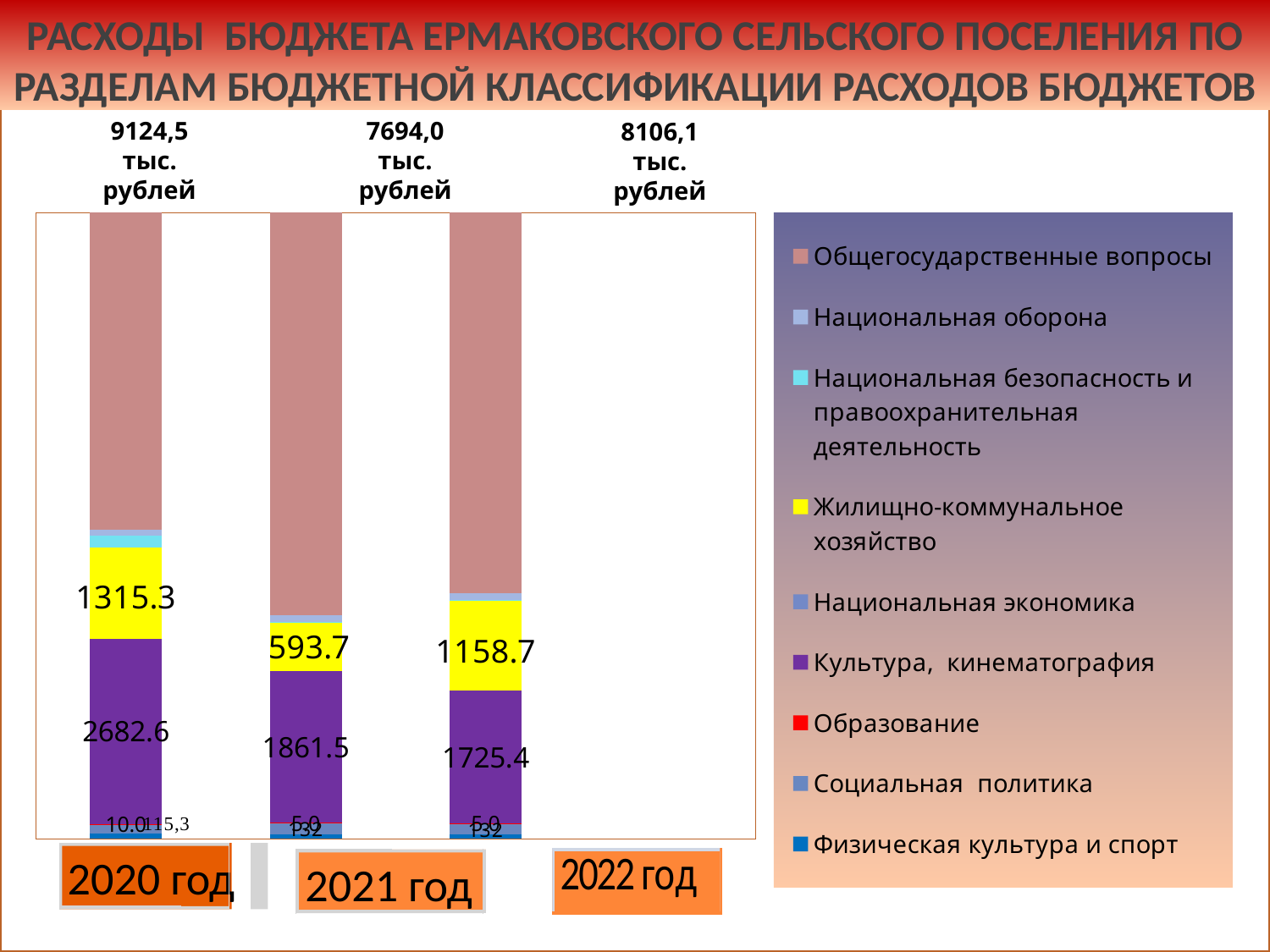
Which year has the highest total expenditure? 2020 год Which year has the lowest total expenditure? 2021 год What is the value for Жилищно-коммунальное хозяйство in 2021 год? 593.7 What kind of chart is shown on the slide? Stacked bar chart Does the value for Культура, кинематография rise or fall from 2020 год to 2022 год? Falls What is the total expenditure shown for 2020 год? 9124,5 тыс. рублей How many years (bars) are shown in the chart? 3 What is the value for Культура, кинематография in 2020 год? 2682.6 How many series does the legend list? 9 What is the difference between the Культура, кинематография values for 2020 год and 2021 год? 821.1 What is the value for Жилищно-коммунальное хозяйство in 2022 год? 1158.7 What is the value for Культура, кинематография in 2022 год? 1725.4